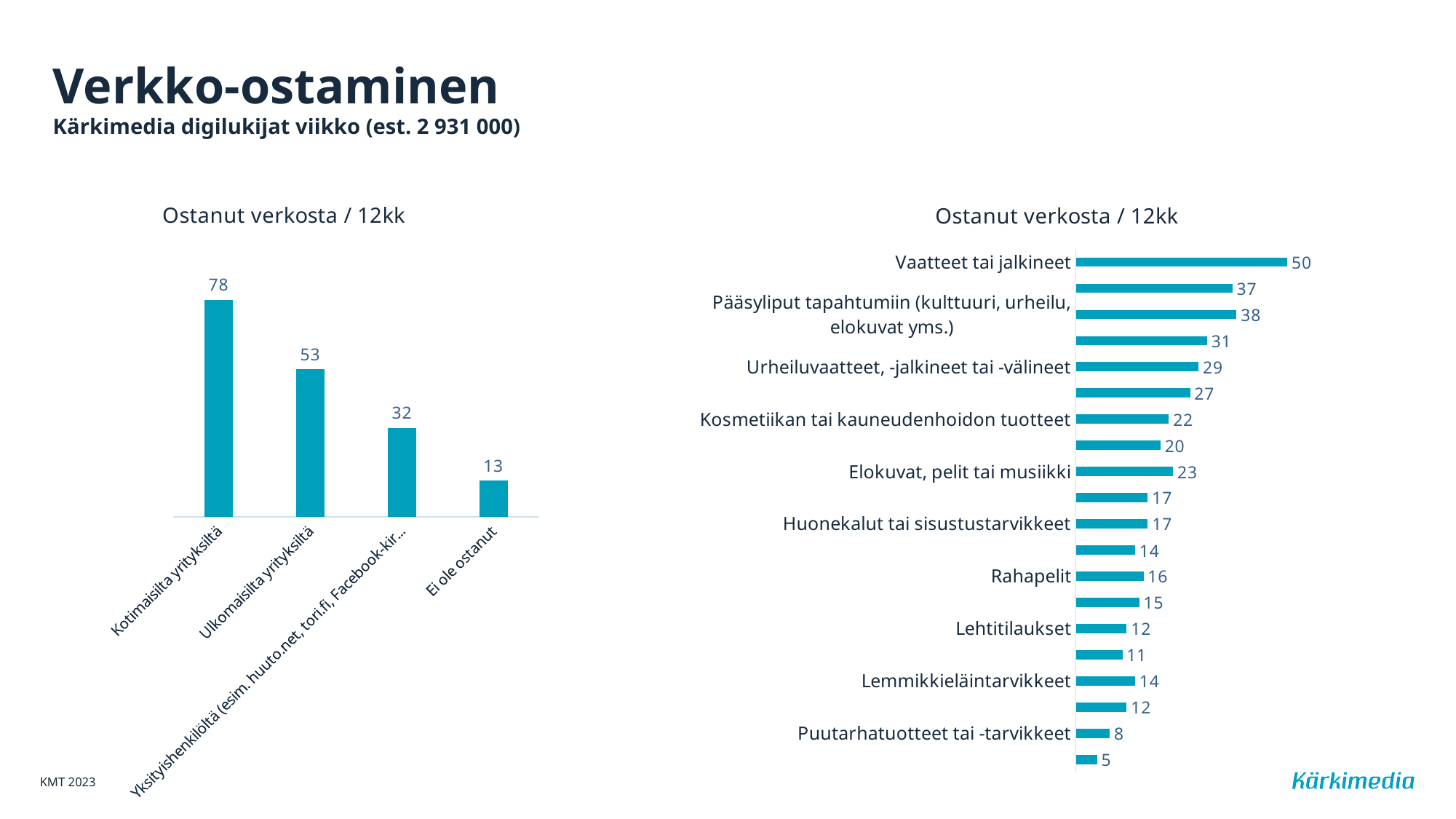
On the right chart, what is the value for Kosmetiikan tai kauneudenhoidon tuotteet? 22 On the left chart, what is the value for Kotimaisilta yrityksiltä? 78 On the left chart, how many categories are shown? 4 On the left chart, what is the difference between Kotimaisilta yrityksiltä and Ulkomaisilta yrityksiltä? 25 On the right chart, what is the difference between Vaatteet tai jalkineet and Lehtitilaukset? 38 On the left chart, do the values rise or fall from left to right? fall What type of chart is the right chart? bar chart On the right chart, what is the value for Puutarhatuotteet tai -tarvikkeet? 8 On the left chart, what is the value for Ei ole ostanut? 13 On the right chart, what is the value for Vaatteet tai jalkineet? 50 On the left chart, which category has the highest value? Kotimaisilta yrityksiltä On the right chart, which is larger, Urheiluvaatteet, -jalkineet tai -välineet or Rahapelit? Urheiluvaatteet, -jalkineet tai -välineet